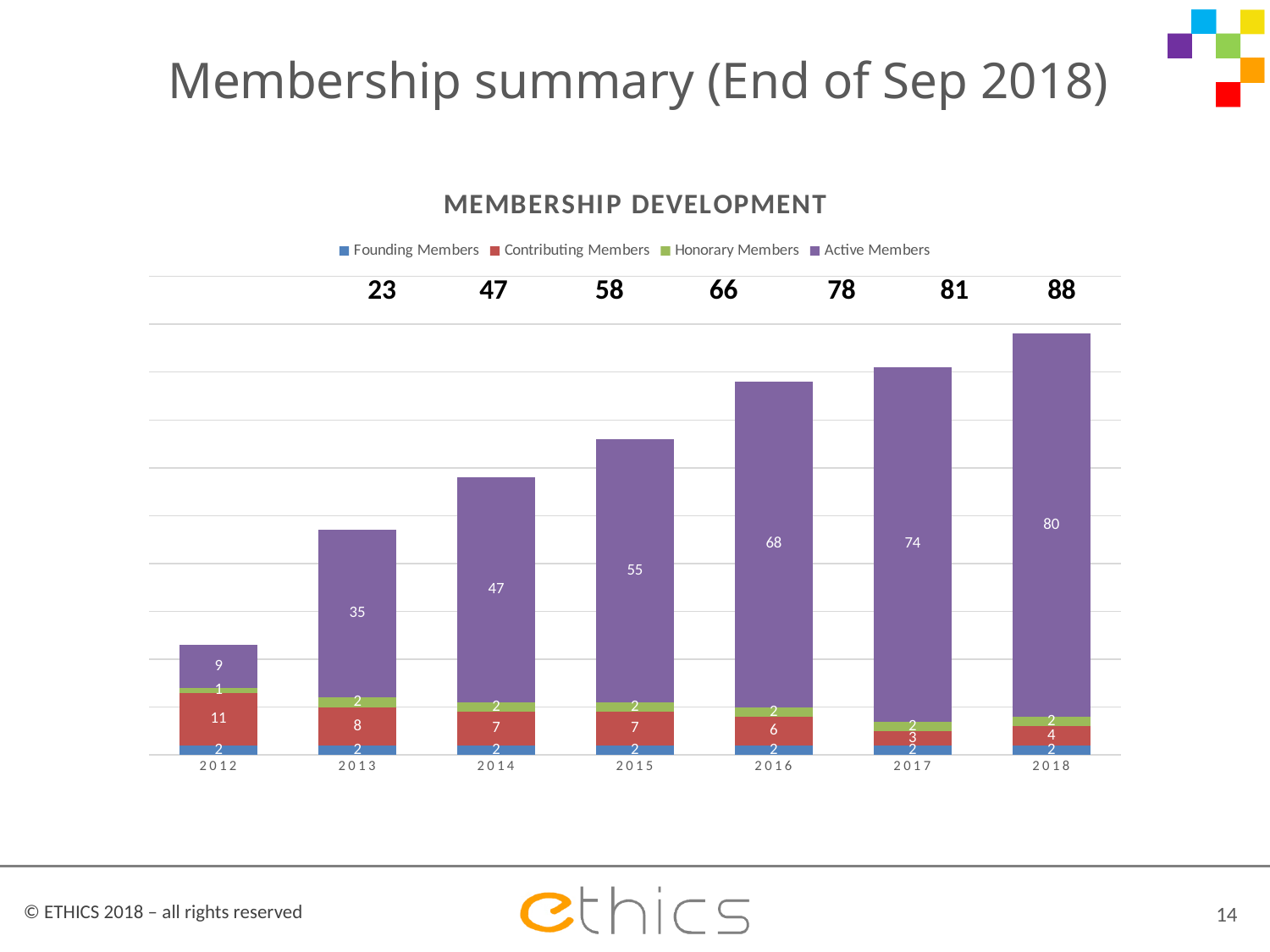
Which year has the highest total membership? 2018 How many years are shown on the x axis? 7 Which year has the lowest value for Active Members? 2012 What is the difference between the total membership in 2018 and in 2012? 65 What is the total membership shown for 2018? 88 What is the value for Contributing Members in 2012? 11 What is the value for Active Members in 2016? 68 How many series does the legend list? 4 What type of chart is shown on the slide? Stacked bar chart Which is larger in 2012: Contributing Members or Active Members? Contributing Members What is the title of the chart? MEMBERSHIP DEVELOPMENT Do the total membership values rise or fall from 2012 to 2018? Rise